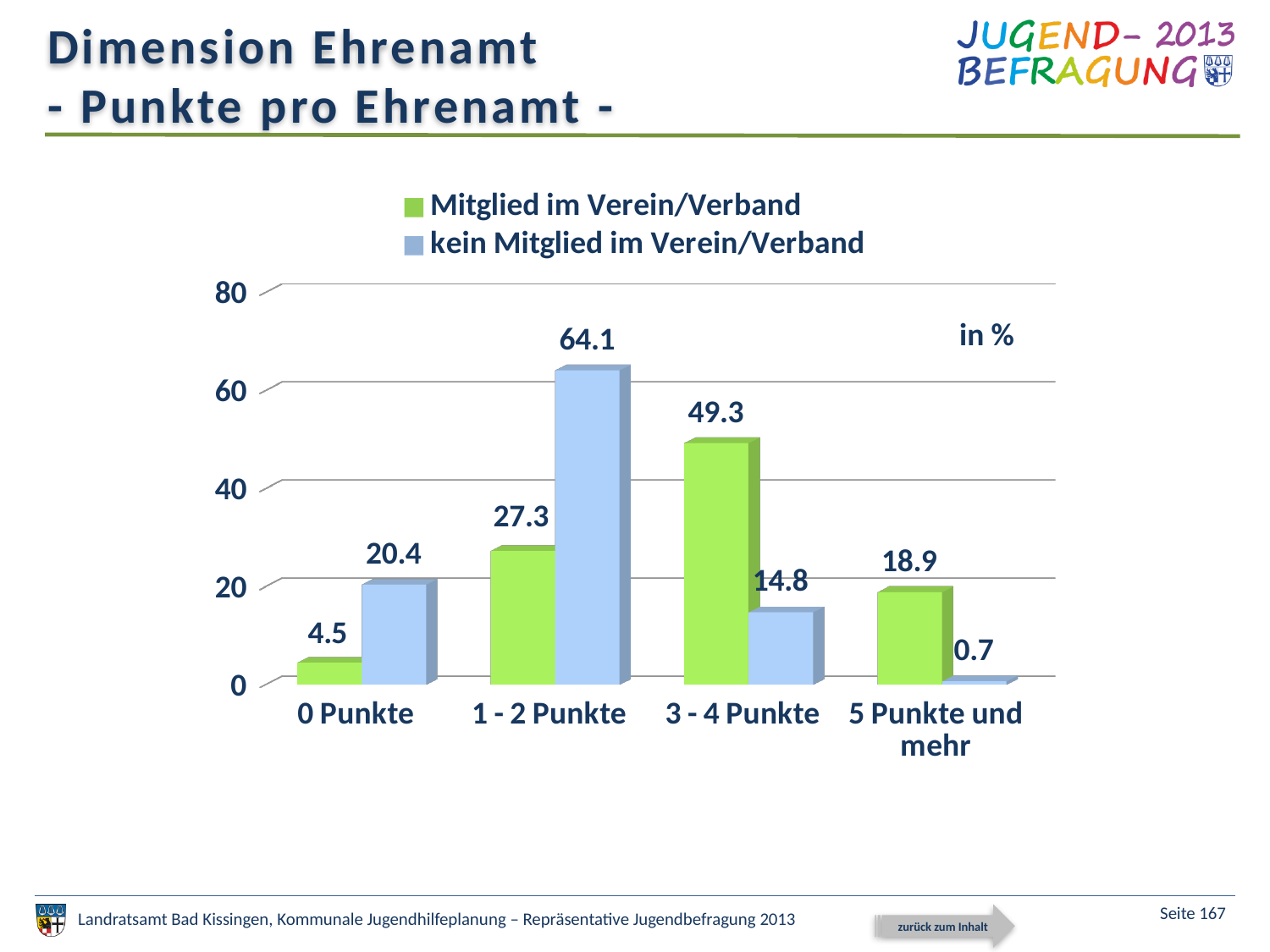
What unit is indicated for the values in the chart? in % What is the difference between the two series in the "1 - 2 Punkte" category? 36.8 How many categories are shown on the x axis? 4 How many series does the legend list? 2 In the "0 Punkte" category, which series has the larger value? kein Mitglied im Verein/Verband What is the value for "kein Mitglied im Verein/Verband" in the "1 - 2 Punkte" category? 64.1 Which category has the highest value for "Mitglied im Verein/Verband"? 3 - 4 Punkte What is the value for "kein Mitglied im Verein/Verband" in the "5 Punkte und mehr" category? 0.7 Which category has the lowest value for "kein Mitglied im Verein/Verband"? 5 Punkte und mehr What kind of chart is shown on the slide? bar chart Is the value for "Mitglied im Verein/Verband" in "1 - 2 Punkte" greater or less than 40? less What is the value for "Mitglied im Verein/Verband" in the "3 - 4 Punkte" category? 49.3